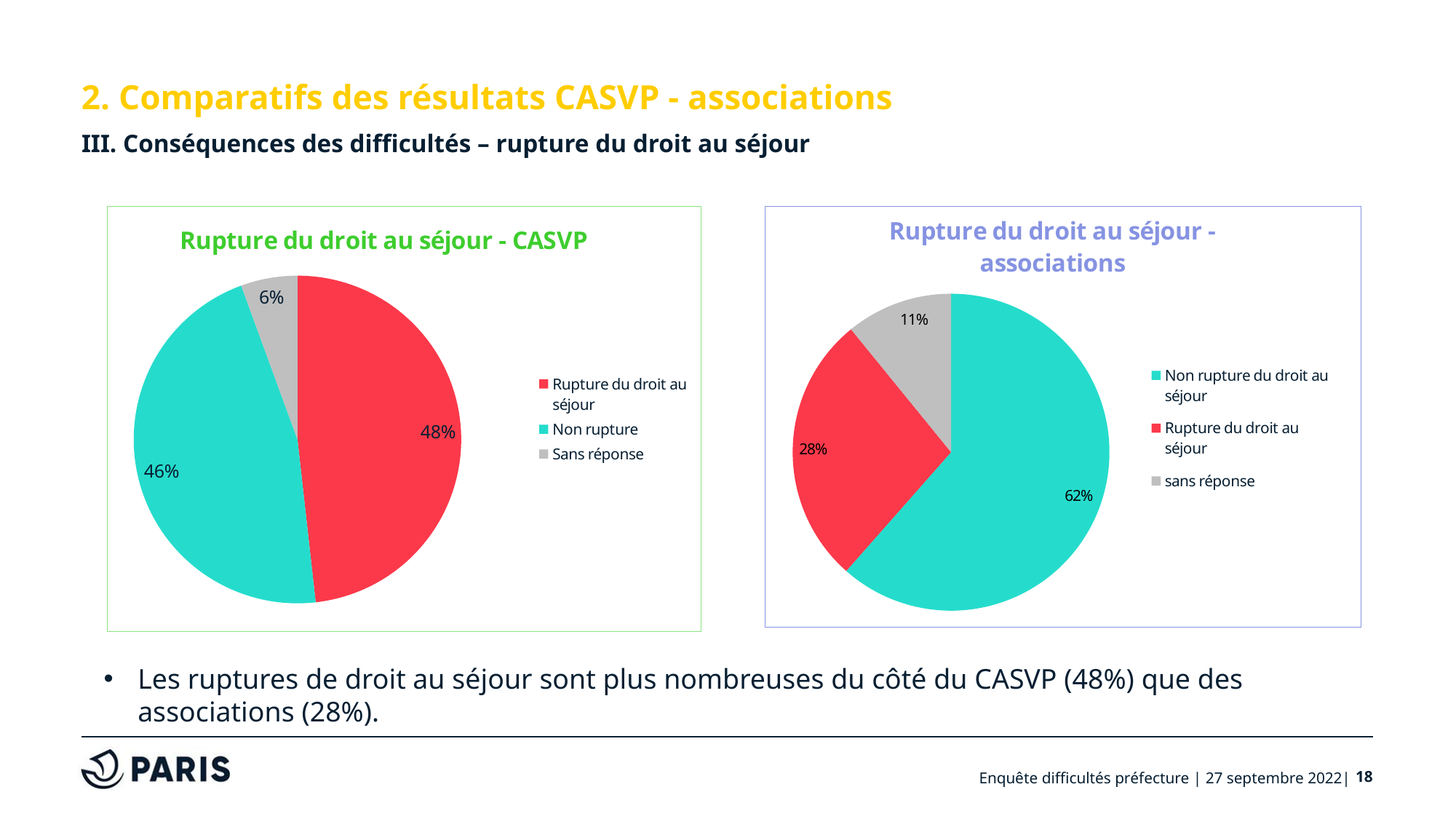
In the chart 'Rupture du droit au séjour - CASVP', what share is 'Sans réponse'? 6% In the chart 'Rupture du droit au séjour - associations', what share is 'Rupture du droit au séjour'? 28% In the chart 'Rupture du droit au séjour - associations', what share is 'Non rupture du droit au séjour'? 62% In the chart 'Rupture du droit au séjour - CASVP', what share is 'Rupture du droit au séjour'? 48% In the chart 'Rupture du droit au séjour - associations', which category has the largest slice? Non rupture du droit au séjour In the chart 'Rupture du droit au séjour - associations', what share is 'sans réponse'? 11% What is the difference between the 'Rupture du droit au séjour' share in the CASVP chart and in the associations chart? 20 percentage points What type of chart is 'Rupture du droit au séjour - CASVP'? Pie chart Which is larger: 'Sans réponse' in the CASVP chart or 'sans réponse' in the associations chart? sans réponse in the associations chart In the chart 'Rupture du droit au séjour - CASVP', what share is 'Non rupture'? 46% How many categories does the legend of the chart 'Rupture du droit au séjour - associations' list? 3 In the chart 'Rupture du droit au séjour - CASVP', which category has the smallest slice? Sans réponse